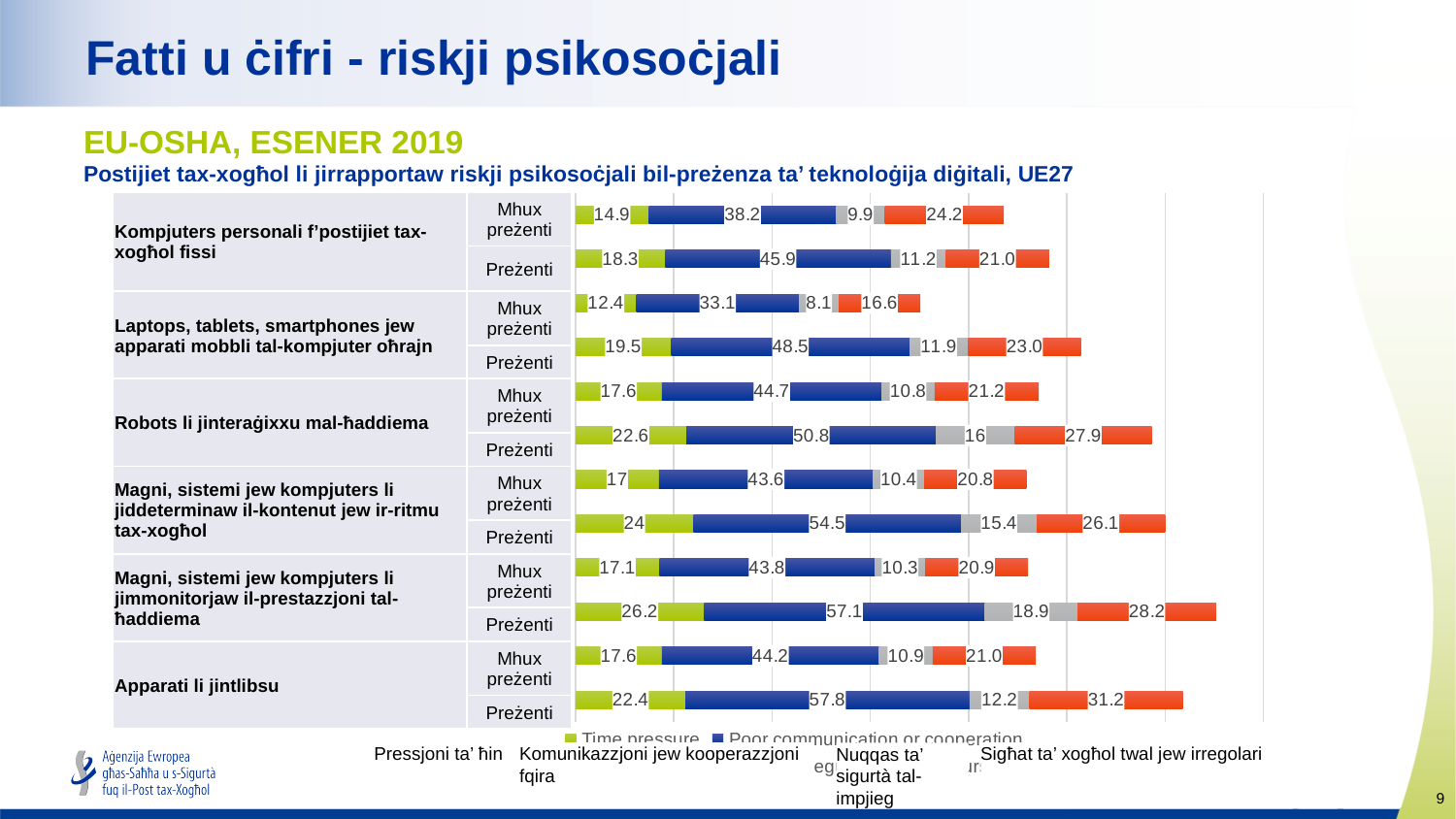
Which is larger: the Sigħat ta' xogħol twal jew irregolari value for 'Apparati li jintlibsu' Preżenti or for 'Magni, sistemi jew kompjuters li jimmonitorjaw il-prestazzjoni tal-ħaddiema' Preżenti? Apparati li jintlibsu (31.2) Which row has the lowest Time pressure (Pressjoni ta' ħin) value in the chart? Laptops, tablets, smartphones jew apparati mobbli tal-kompjuter oħrajn – Mhux preżenti What is the Nuqqas ta' sigurtà tal-impjieg (job insecurity) value for 'Magni, sistemi jew kompjuters li jimmonitorjaw il-prestazzjoni tal-ħaddiema' in the Preżenti row? 18.9 What kind of chart is shown on the slide? Stacked bar chart What is the Poor communication or cooperation value for 'Robots li jinteraġixxu mal-ħaddiema' in the Preżenti row? 50.8 What is the total of the stacked bar for 'Laptops, tablets, smartphones jew apparati mobbli tal-kompjuter oħrajn' in the Mhux preżenti row? 70.2 How many series does the chart's legend list? 4 How many technology categories are shown in the chart? 6 Among the Preżenti rows, which technology has the highest Poor communication or cooperation value? Apparati li jintlibsu For 'Kompjuters personali f'postijiet tax-xogħol fissi', how much higher is the Time pressure value in the Preżenti row than in the Mhux preżenti row? 3.4 What is the Time pressure (Pressjoni ta' ħin) value for 'Apparati li jintlibsu' in the Preżenti row? 22.4 What colour represents the Time pressure (Pressjoni ta' ħin) series in the chart? Green